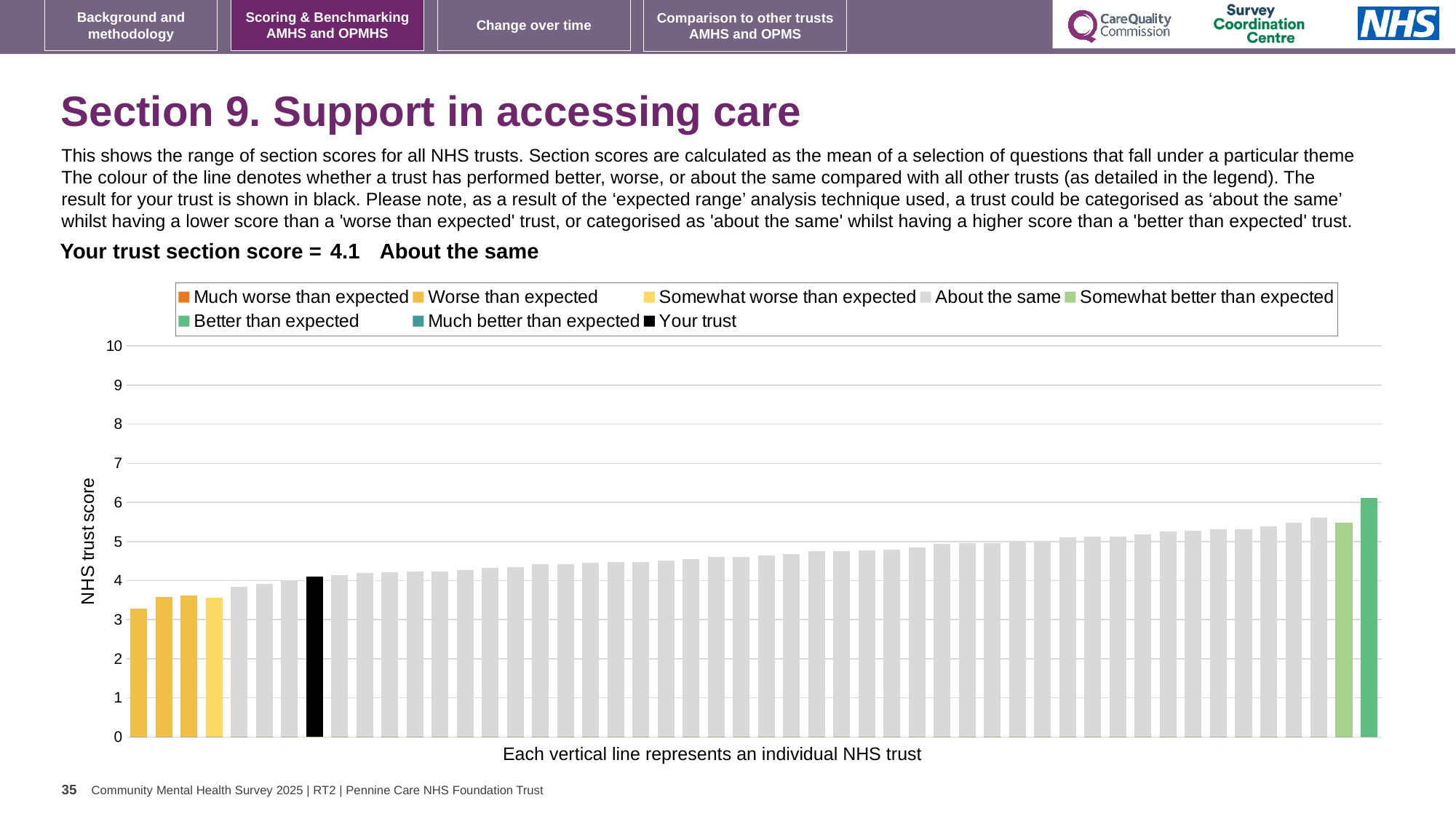
What is the section score for your trust? 4.1 Is the value of the lowest bar greater or less than 4? less How many entries does the chart legend list? 8 What kind of chart is shown on the slide? bar chart Is the value of the lowest bar greater or less than 3? greater What is the label on the vertical axis of the chart? NHS trust score Is the value of the highest bar greater or less than 5? greater Which category is your trust's section score placed in? About the same What colour is the bar representing your trust? black Do the bar values rise or fall from left to right along the x axis? rise